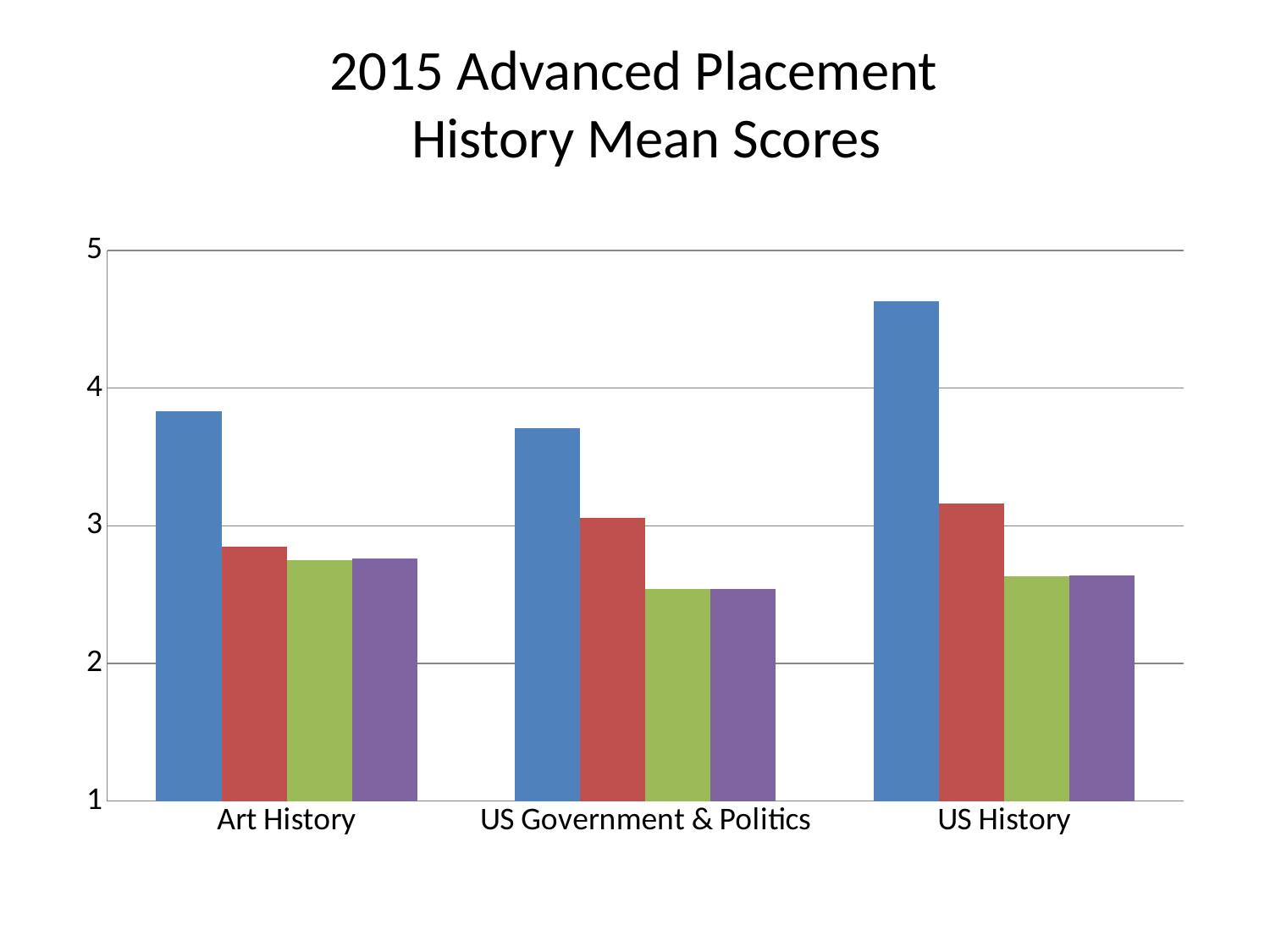
What is the title of the chart? 2015 Advanced Placement History Mean Scores Is the blue bar for US History greater or less than 4? greater Is the blue bar for US Government & Politics greater or less than 3? greater Is the red bar for Art History greater or less than 3? less What kind of chart is shown on the slide? bar chart How many bars are plotted for each category? 4 Which category has the tallest blue bar? US History Which is larger for US History, the blue bar or the red bar? the blue bar How many categories are shown on the x axis? 3 Which is larger, the blue bar for US History or the blue bar for Art History? US History